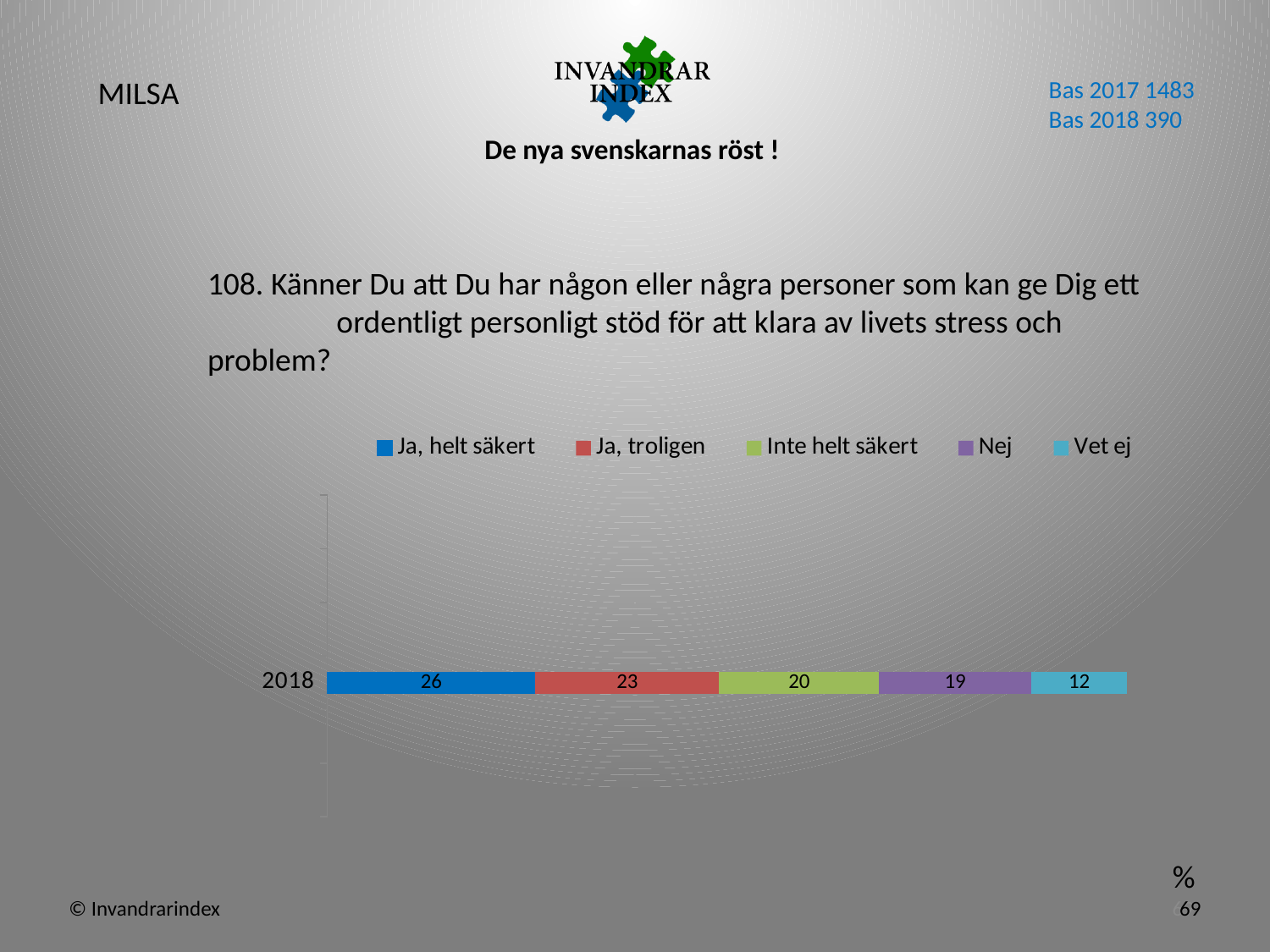
Which series has the lowest value in the 2018 bar? Vet ej What is the value for "Vet ej" in 2018? 12 What is the value for "Nej" in 2018? 19 What is the value for "Ja, troligen" in 2018? 23 What kind of chart is shown on the slide? Stacked bar chart What is the difference between "Ja, helt säkert" and "Vet ej" in 2018? 14 Which series has the highest value in the 2018 bar? Ja, helt säkert What is the value for "Inte helt säkert" in 2018? 20 Which is larger in 2018, "Ja, troligen" or "Nej"? Ja, troligen What is the value for "Ja, helt säkert" in 2018? 26 How many series does the legend list? 5 What is the total of the 2018 stacked bar? 100